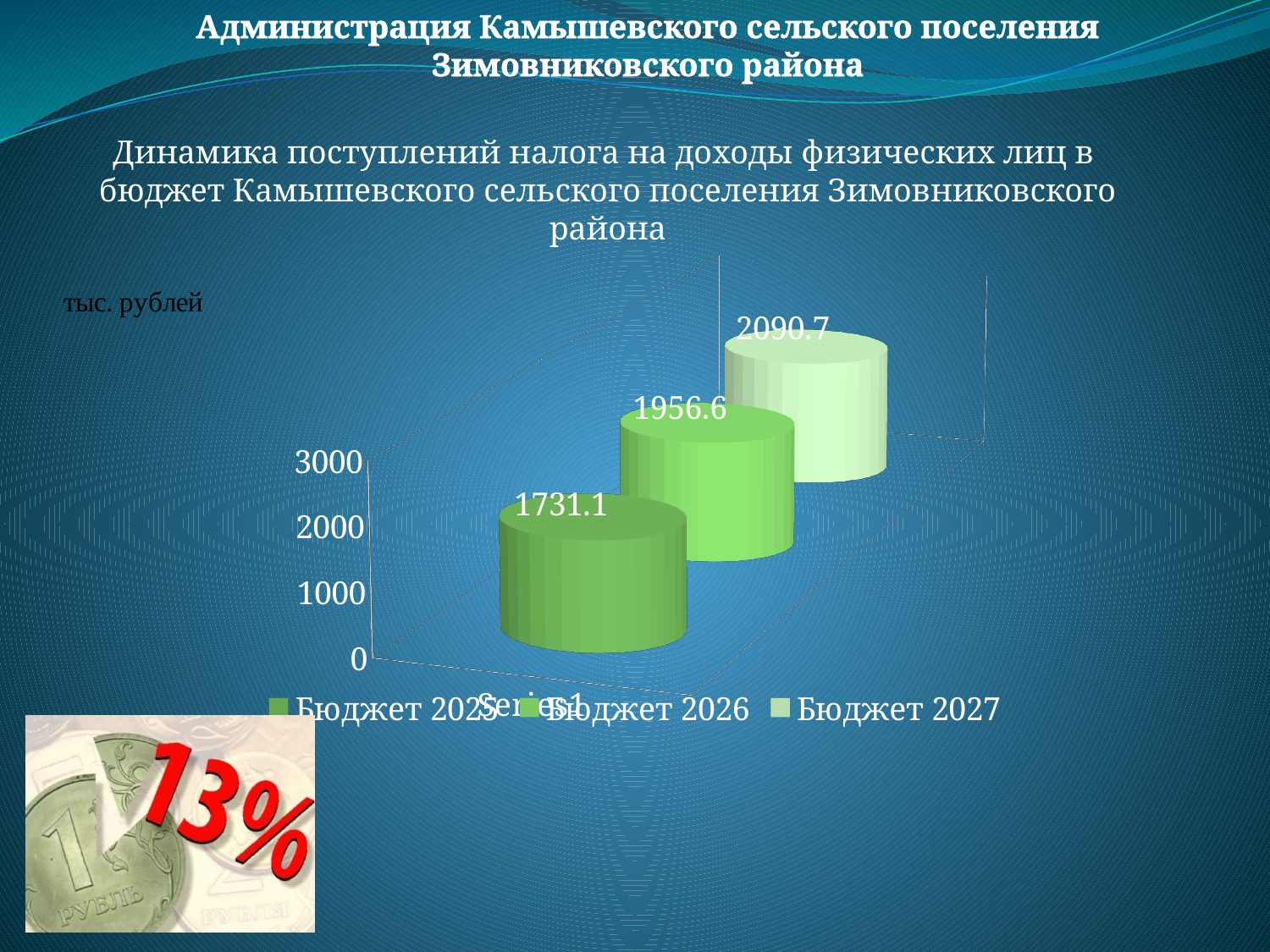
What is the value for Бюджет 2027? 2090.7 Which is larger, the value for Бюджет 2026 or Бюджет 2027? Бюджет 2027 Is the value for Бюджет 2025 greater or less than 2000? less How many series does the legend list? 3 What is the difference between the values for Бюджет 2027 and Бюджет 2025? 359.6 What is the value for Бюджет 2025? 1731.1 Do the values rise or fall from Бюджет 2025 to Бюджет 2027? rise What kind of chart is shown on the slide? bar chart What is the value for Бюджет 2026? 1956.6 Which budget year has the lowest value? Бюджет 2025 What is the difference between the values for Бюджет 2026 and Бюджет 2025? 225.5 Which budget year has the highest value? Бюджет 2027